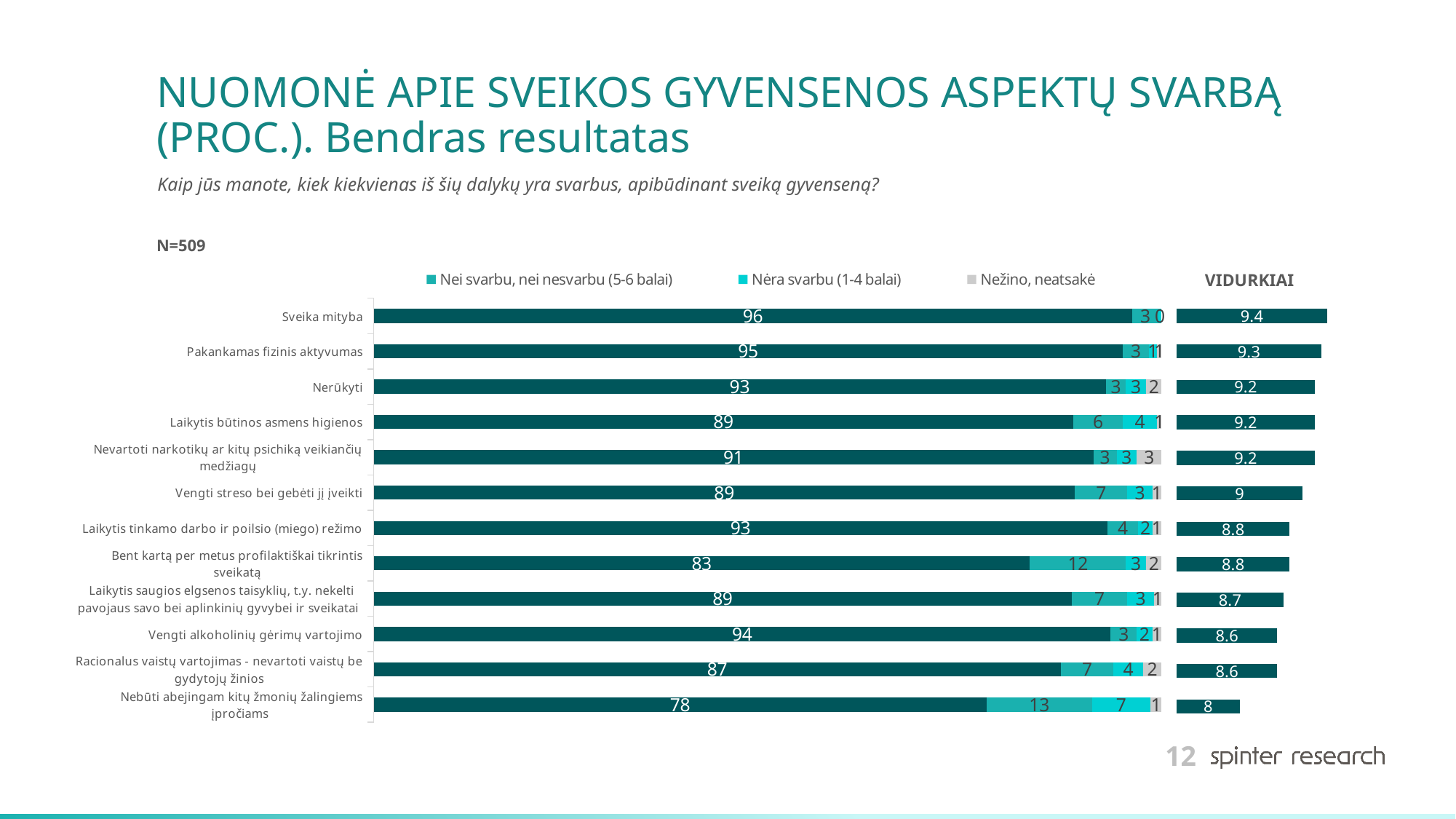
What is the "Nei svarbu, nei nesvarbu (5-6 balai)" value for "Bent kartą per metus profilaktiškai tikrintis sveikatą"? 12 Which category has the highest VIDURKIAI (average) value? Sveika mityba What type of chart is used on this slide? bar chart What is the difference between the highest VIDURKIAI value (Sveika mityba) and the lowest (Nebūti abejingam kitų žmonių žalingiems įpročiams)? 1.4 What sample size (N) is stated on the slide? N=509 What is the value of the dark teal (largest) segment for "Sveika mityba"? 96 What is the difference between the dark teal segment values for "Sveika mityba" and "Nebūti abejingam kitų žmonių žalingiems įpročiams"? 18 Which has a larger dark teal segment value: "Nerūkyti" or "Laikytis būtinos asmens higienos"? Nerūkyti What is the VIDURKIAI (average) value shown for "Nebūti abejingam kitų žmonių žalingiems įpročiams"? 8 How many categories (health lifestyle aspects) are shown in the chart? 12 Which category has the lowest value in the dark teal (largest) segment? Nebūti abejingam kitų žmonių žalingiems įpročiams What is the "Nėra svarbu (1-4 balai)" value for "Nebūti abejingam kitų žmonių žalingiems įpročiams"? 7